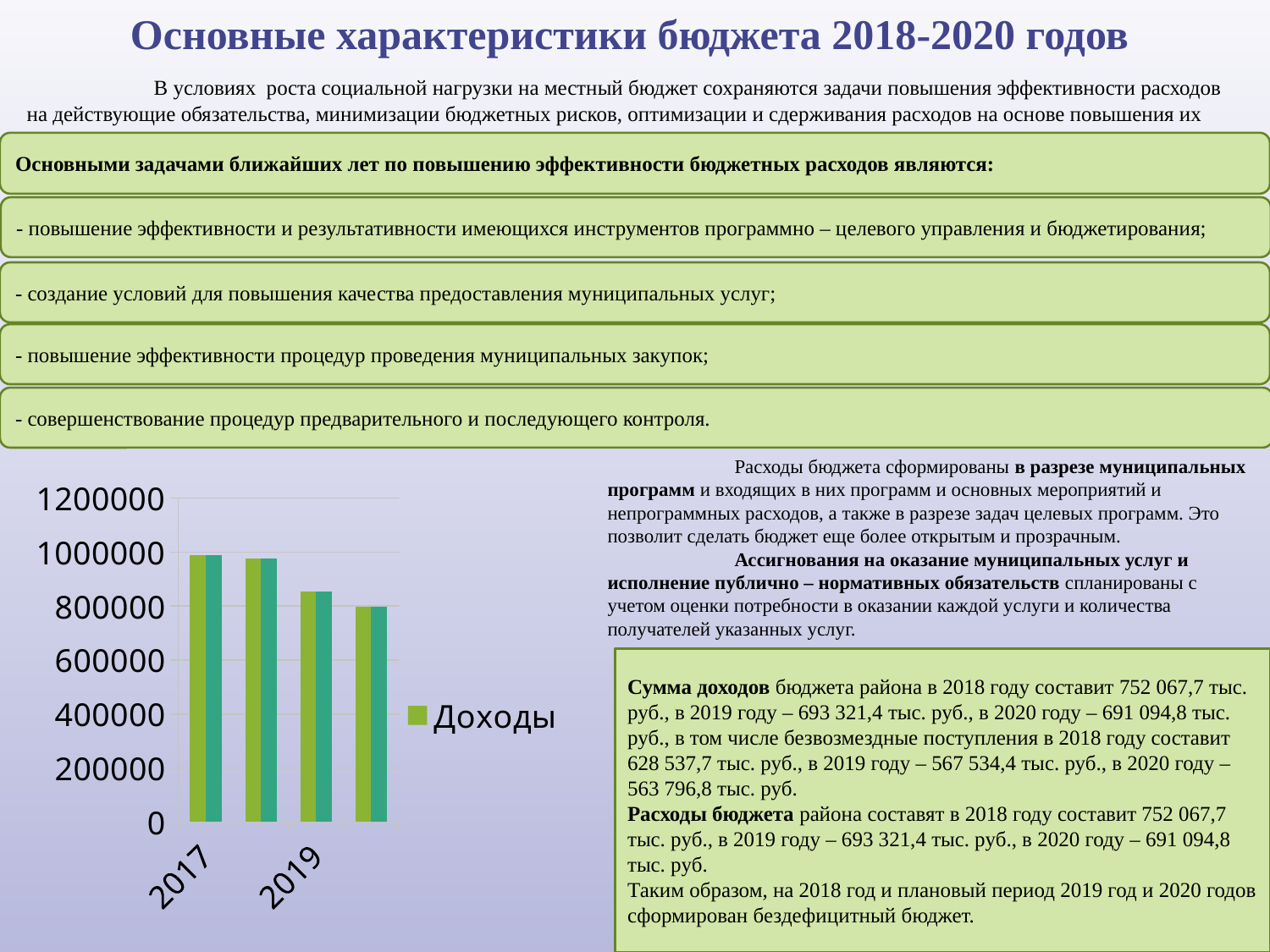
Is the value for 2019 greater or less than 800000? greater What is the name of the series shown in the chart legend? Доходы Is the value for 2019 greater or less than 1000000? less What is the highest value shown on the chart's vertical axis? 1200000 Do the values in the chart rise or fall from left to right along the x axis? fall How many bars are plotted in the chart? 8 How many series does the chart legend list? 1 What kind of chart is shown on the slide? bar chart Is the value for 2017 greater or less than 800000? greater Which is larger, the value for 2017 or the value for 2019? 2017